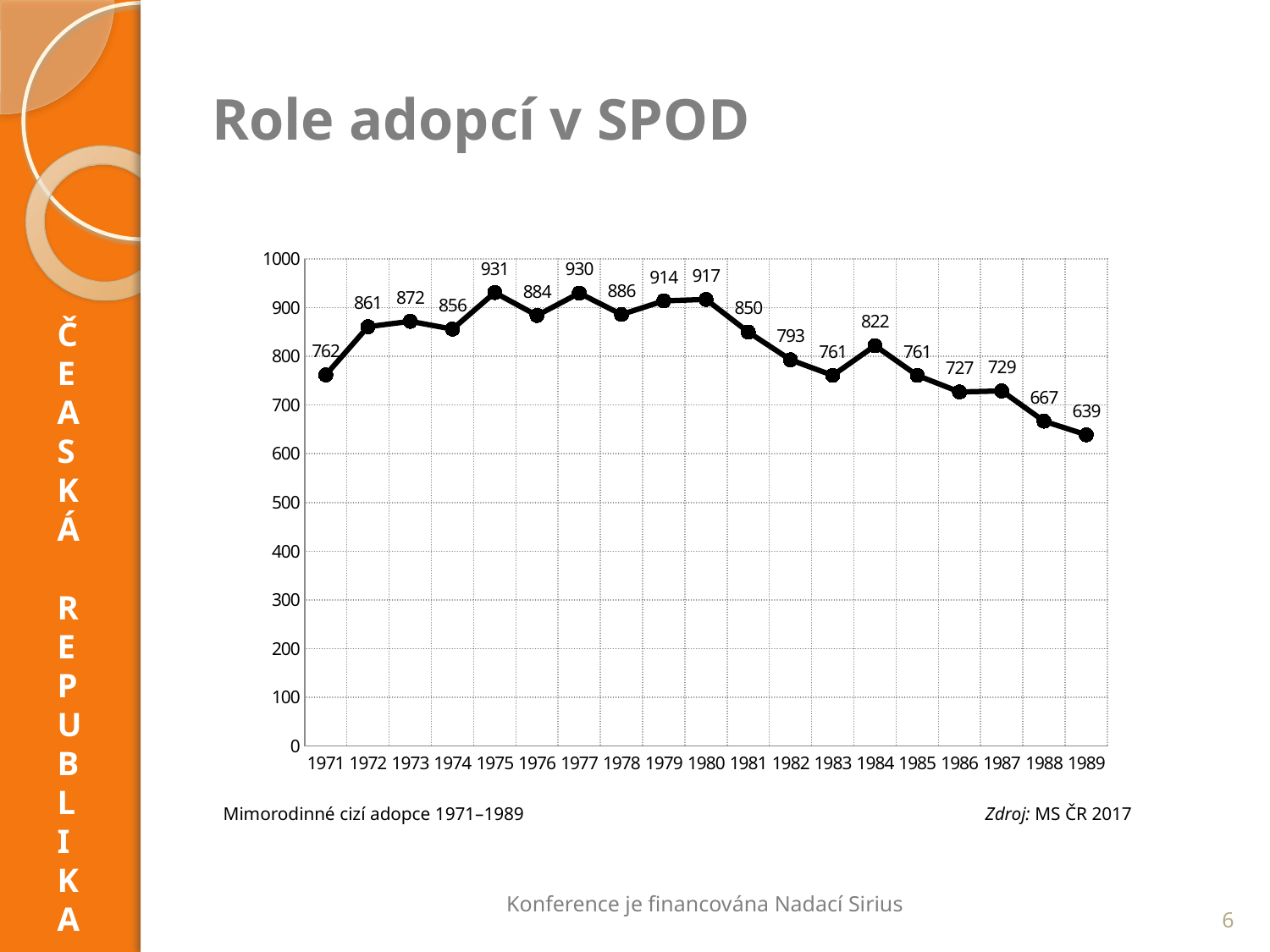
What is the difference between the values for 1971 and 1989? 123 Which year has the highest value? 1975 What is the value for 1989? 639 What is the value for 1971? 762 What kind of chart is shown on the slide? line chart How many years are plotted on the x axis? 19 Do the values rise or fall from 1980 to 1989? fall Which is larger, the value for 1972 or the value for 1988? 1972 Which year has the lowest value? 1989 What is the value for 1984? 822 What is the difference between the values for 1975 and 1989? 292 What is the caption below the chart on the left? Mimorodinné cizí adopce 1971–1989